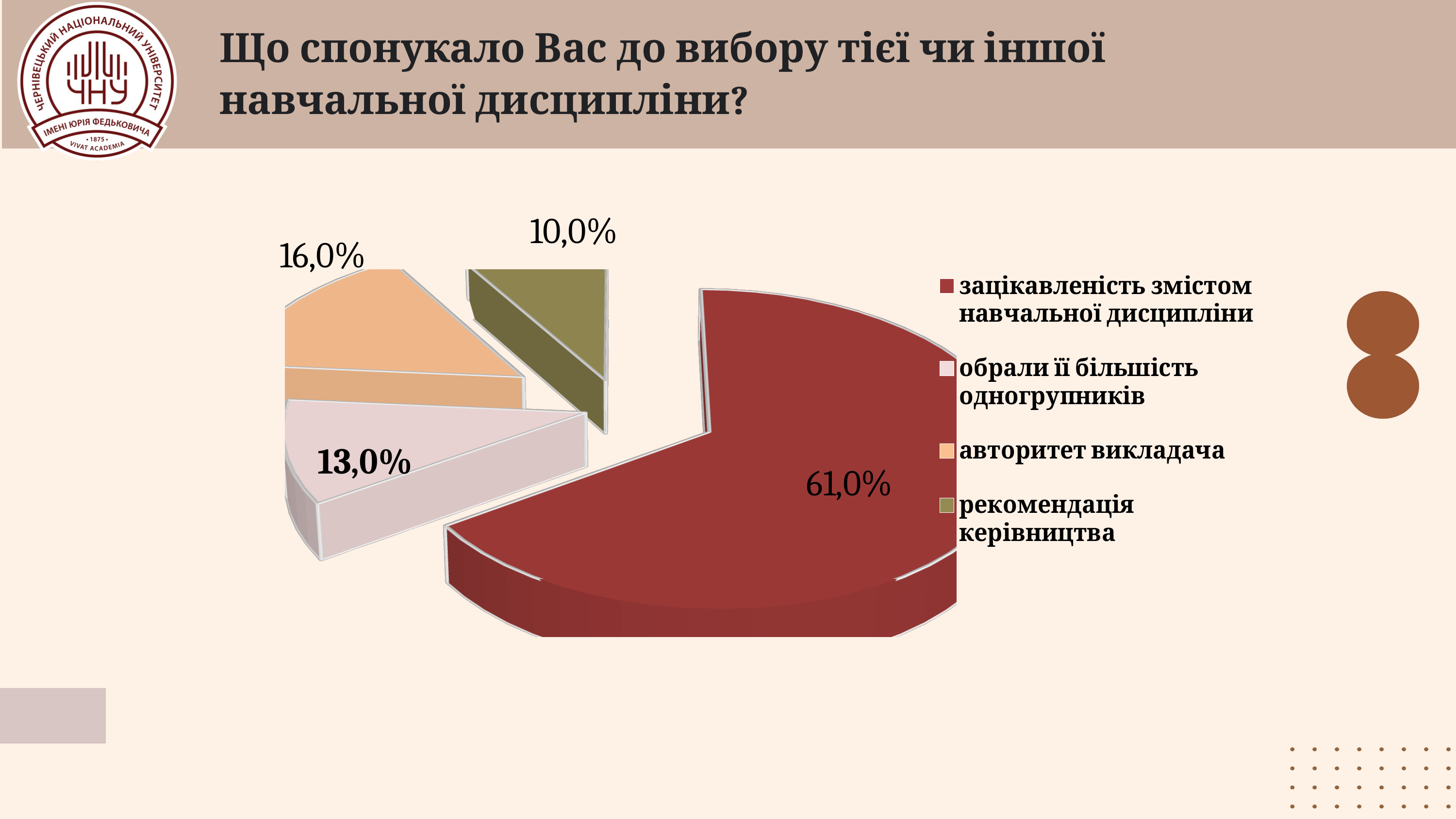
Which category has the smallest slice of the pie? рекомендація керівництва How many slices does the pie chart have? 4 What is the difference between the shares for "зацікавленість змістом навчальної дисципліни" and "авторитет викладача"? 45,0% What kind of chart is shown on the slide? Pie chart What share of the pie is labelled for "рекомендація керівництва"? 10,0% What share of the pie is labelled for "авторитет викладача"? 16,0% What share of the pie is labelled for "обрали її більшість одногрупників"? 13,0% What share of the pie is labelled for "зацікавленість змістом навчальної дисципліни"? 61,0% How many entries does the legend list? 4 What colour is the slice for "рекомендація керівництва"? Olive green Which category has the largest slice of the pie? зацікавленість змістом навчальної дисципліни Which is larger: the share for "авторитет викладача" or the share for "обрали її більшість одногрупників"? авторитет викладача